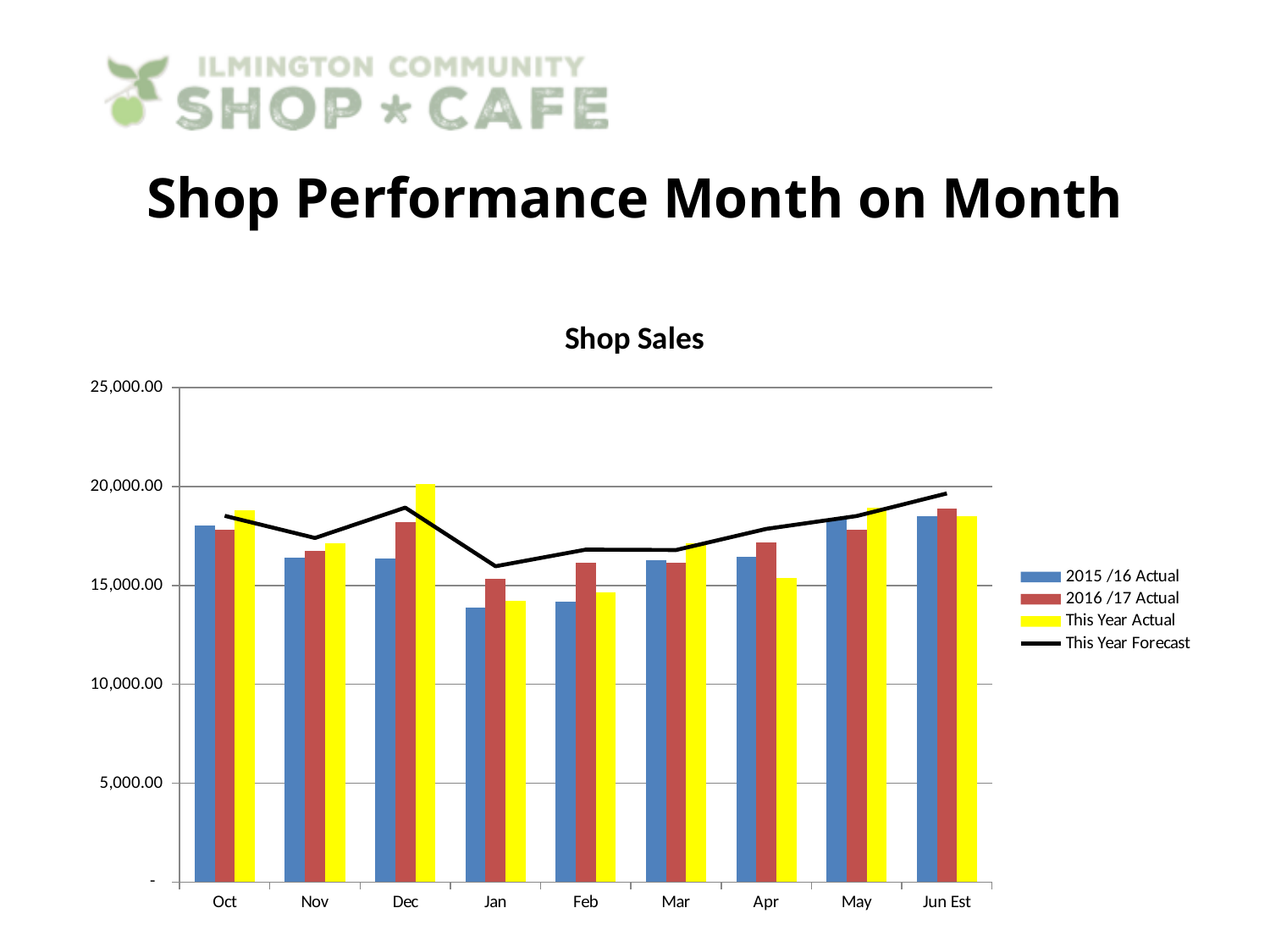
For Jan, which is larger: the 2016 /17 Actual value or the This Year Actual value? 2016 /17 Actual What is the title of the chart on the slide? Shop Sales In which month is the This Year Actual value highest? Dec How many series does the legend of the Shop Sales chart list? 4 Does the This Year Actual value rise or fall from Dec to Jan? fall Is the This Year Forecast value for Jun Est greater or less than 15,000.00? greater What kind of chart is shown on the slide? bar chart with a line series How many months (categories) are shown on the x axis of the Shop Sales chart? 9 In which month is the 2015 /16 Actual value lowest? Jan Is the 2015 /16 Actual value for Oct greater or less than 15,000.00? greater For Dec, which is larger: the This Year Actual value or the 2015 /16 Actual value? This Year Actual Is the This Year Actual value for Jan greater or less than 15,000.00? less